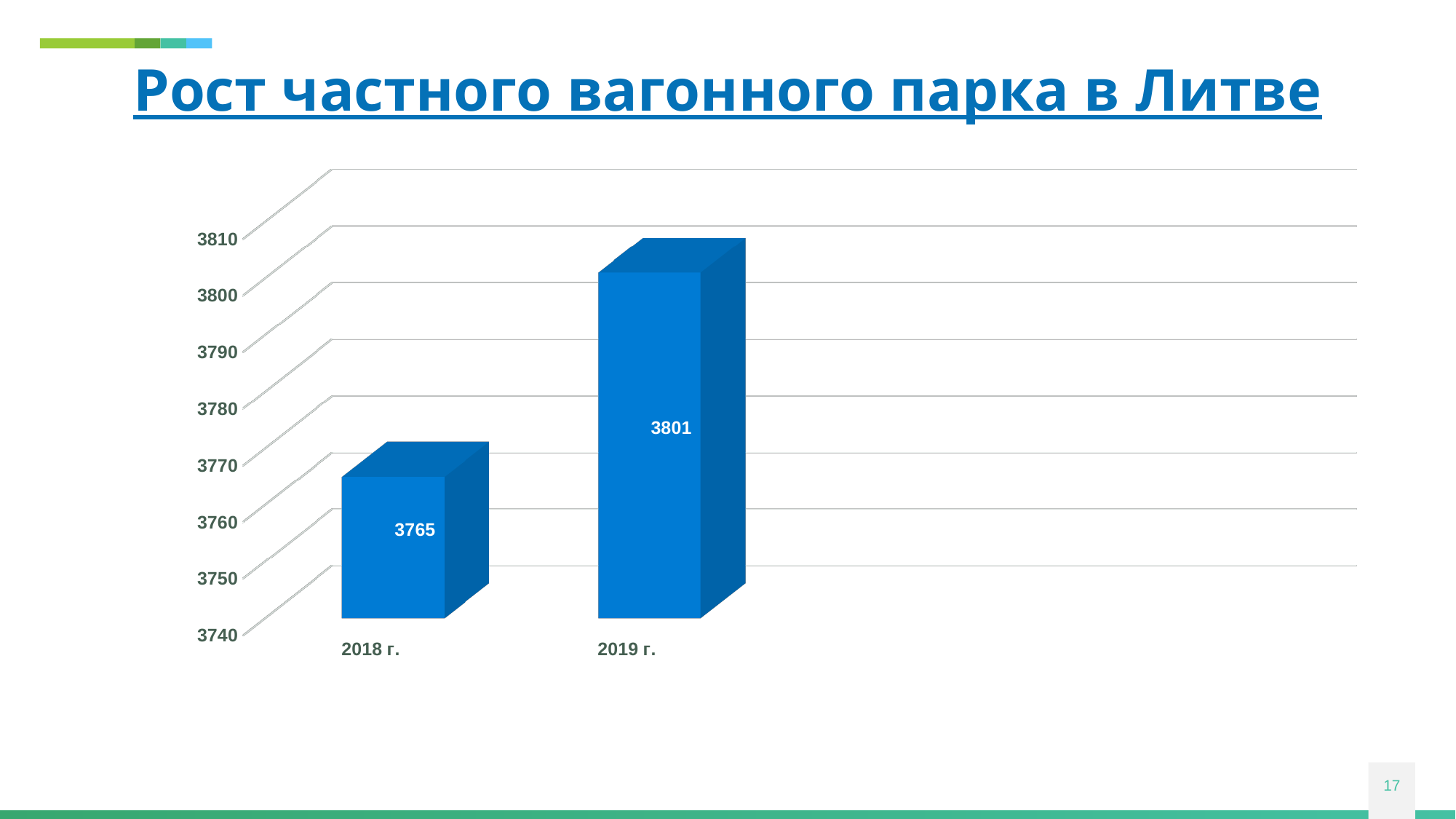
What is the title of the slide? Рост частного вагонного парка в Литве What is the value for 2018 г.? 3765 Is the value for 2019 г. greater or less than 3800? greater Which year has the lowest value? 2018 г. What is the difference between the values for 2019 г. and 2018 г.? 36 Which year has the highest value? 2019 г. What kind of chart is shown on the slide? bar chart How many categories are shown on the chart? 2 Do the values rise or fall from 2018 г. to 2019 г.? rise Is the value for 2018 г. greater or less than 3770? less What is the value for 2019 г.? 3801 Which is larger, the value for 2018 г. or the value for 2019 г.? 2019 г.